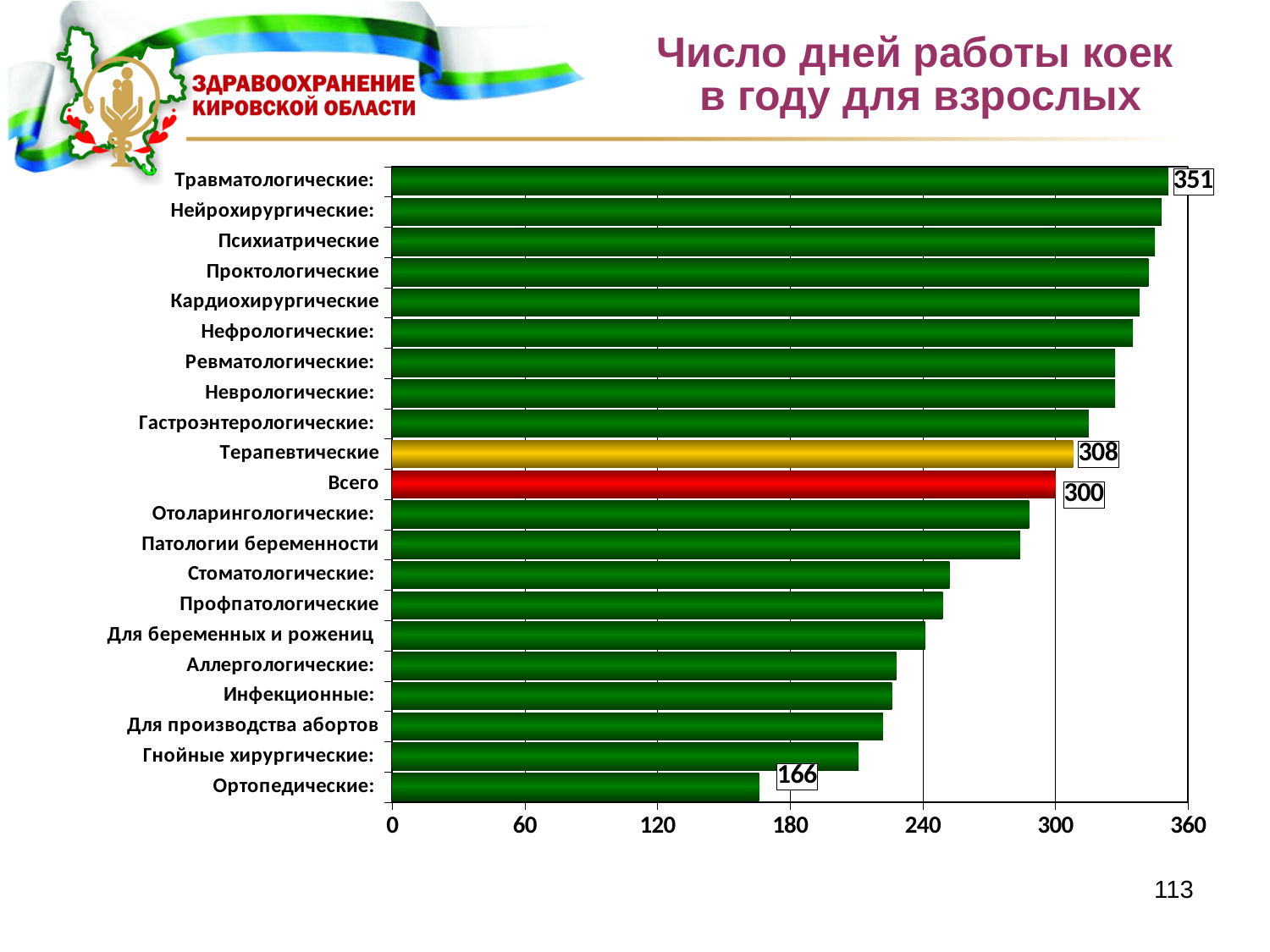
What is the difference between the values for Травматологические and Ортопедические? 185 Which is larger, the value for Нейрохирургические or the value for Гастроэнтерологические? Нейрохирургические What is the difference between the values for Терапевтические and Всего? 8 What is the value for Всего? 300 What is the value for Терапевтические? 308 What is the value for Травматологические? 351 What is the value for Ортопедические? 166 Which category has the lowest value? Ортопедические Which category has the highest value? Травматологические What type of chart is shown on the slide? bar chart How many categories are shown in the chart? 21 Is the value for Гнойные хирургические greater or less than 180? greater